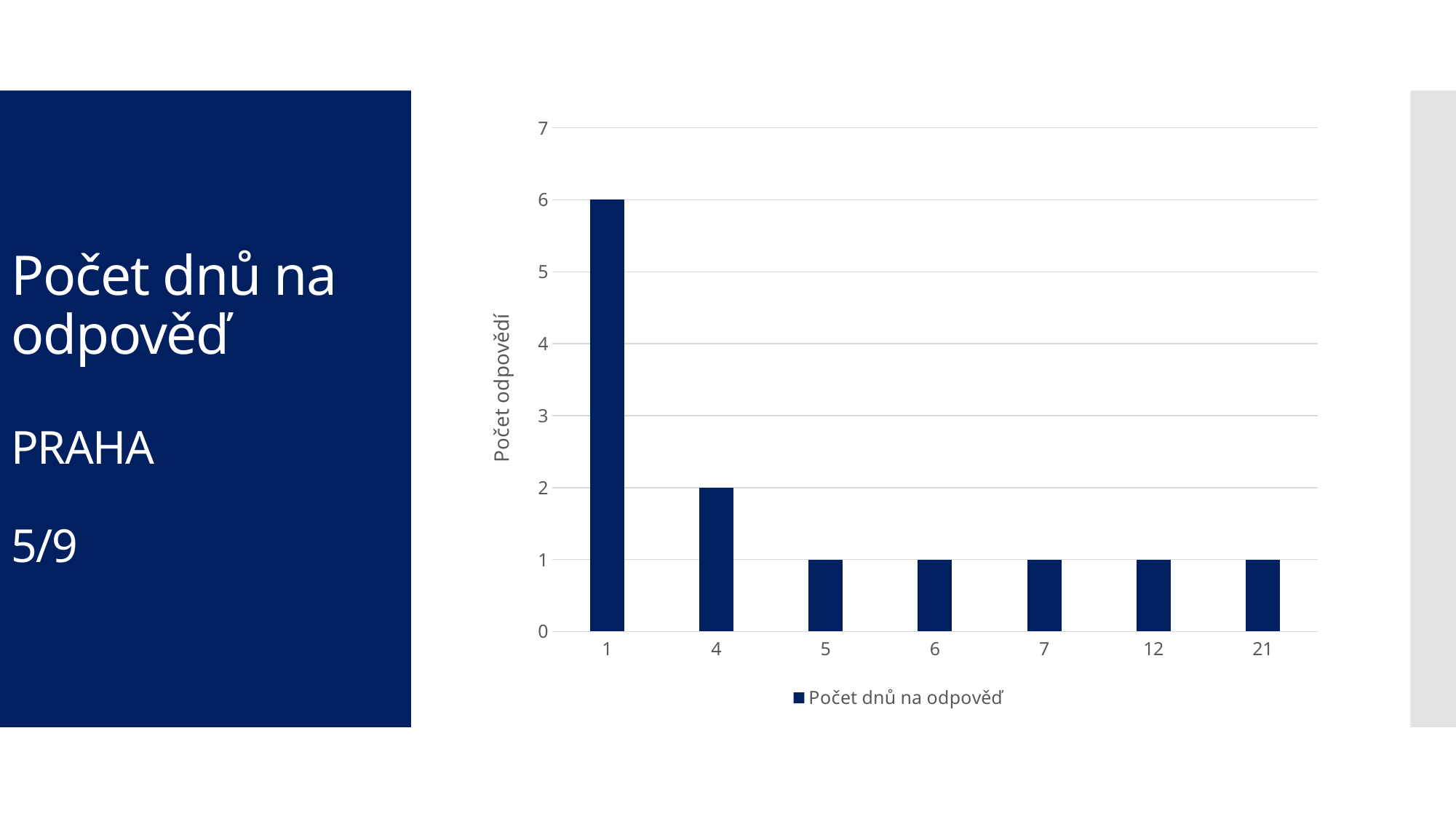
What is the difference between the values for category 1 and category 4? 4 How many categories are shown on the x axis of the chart? 7 How many series does the chart legend list? 1 Do the values rise or fall from left to right along the x axis? fall Which has the larger value, category 4 or category 7? 4 What is the value (Počet odpovědí) for category 4? 2 What is the label of the series shown in the chart legend? Počet dnů na odpověď What is the value (Počet odpovědí) for category 1? 6 Is the value for category 1 greater or less than 5? greater Which category has the highest value in the chart? 1 What type of chart is shown on the slide? bar chart What is the value (Počet odpovědí) for category 21? 1